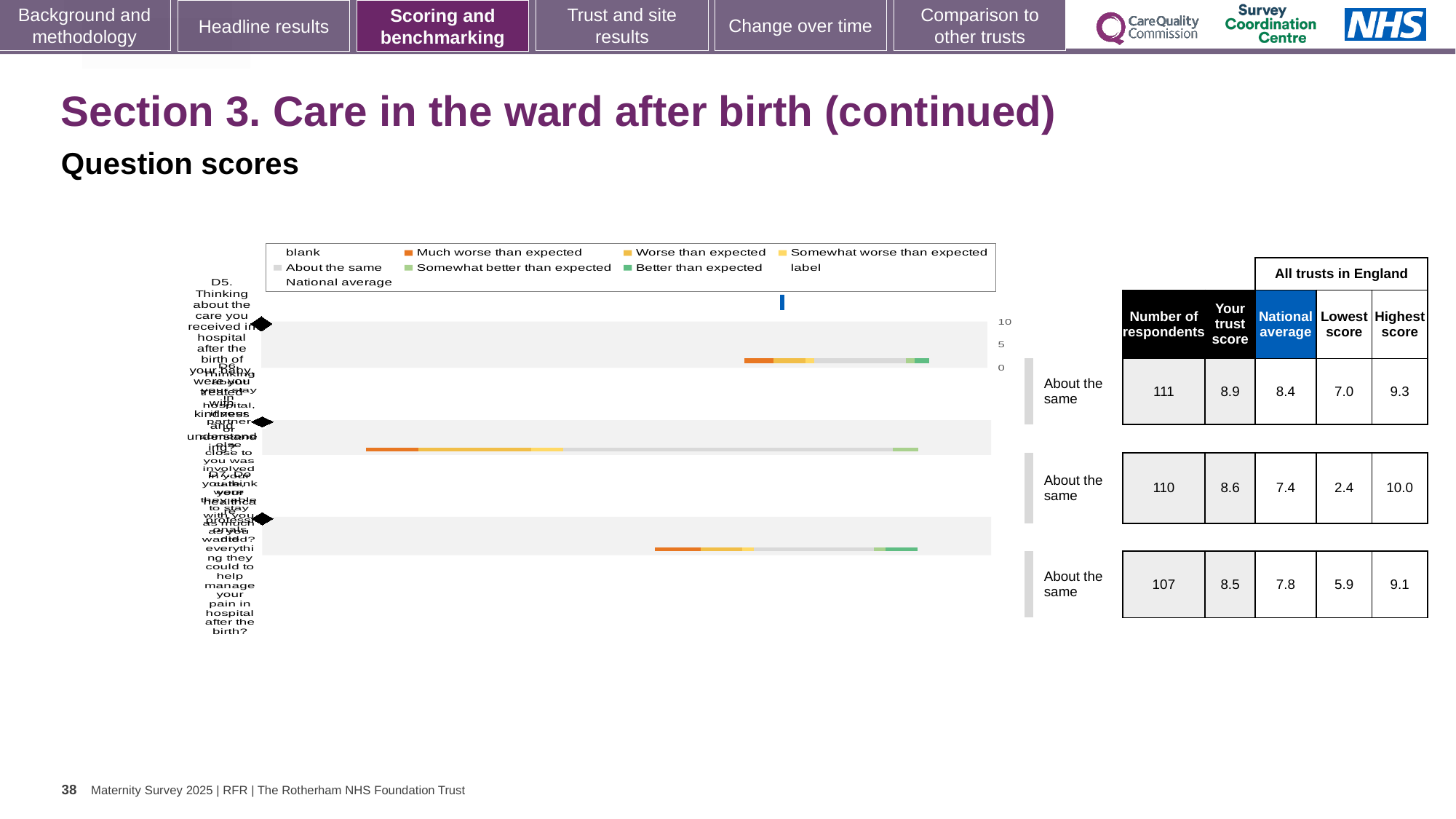
In the table beside the chart, what is the highest score in the second row? 10.0 What benchmark label is shown for each of the three rows next to the chart? About the same In the table beside the chart, is 'Your trust score' or the national average larger in the third row? Your trust score In the table beside the chart, what is 'Your trust score' in the second row? 8.6 What kind of chart is shown on the slide? bar chart In the table beside the chart, what is the difference between 'Your trust score' and the national average in the first row? 0.5 In the table beside the chart, what is the national average in the third row? 7.8 What colour does the legend use for 'Better than expected'? green How many stacked bars are plotted in the chart? 3 What colour does the legend use for 'Much worse than expected'? orange In the table beside the chart, what is the number of respondents in the first row? 111 In the table beside the chart, which row has the lowest 'Lowest score'? second row (2.4)